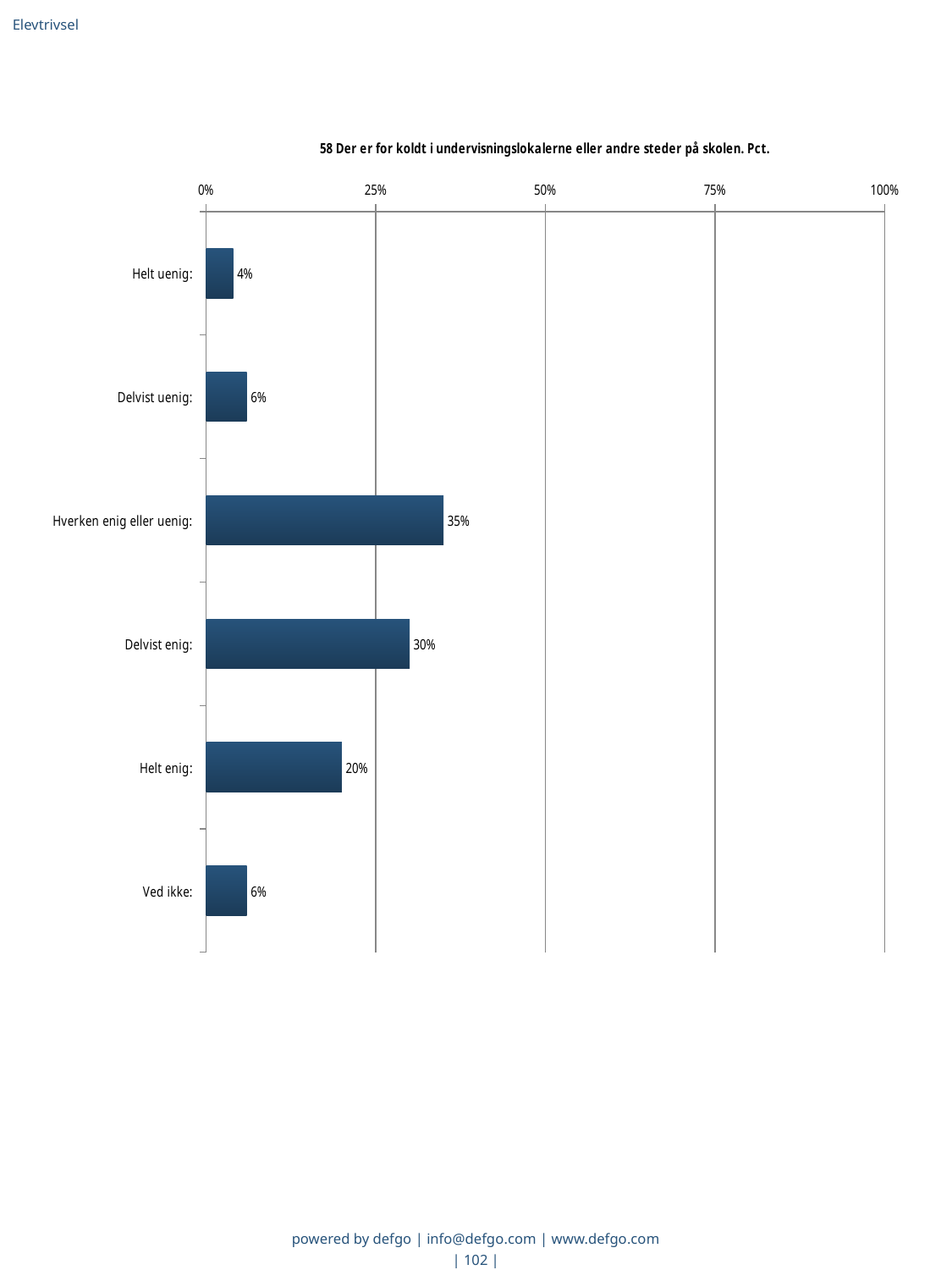
What is the value for "Hverken enig eller uenig"? 35% What is the difference between the values for "Hverken enig eller uenig" and "Delvist enig"? 5% Which category has the highest value? Hverken enig eller uenig What is the value for "Delvist enig"? 30% What is the value for "Helt enig"? 20% What is the difference between the values for "Helt enig" and "Helt uenig"? 16% How many categories are shown in the chart? 6 What kind of chart is shown on the slide? Bar chart What is the title of the chart? 58 Der er for koldt i undervisningslokalerne eller andre steder på skolen. Pct. Is the value for "Hverken enig eller uenig" greater or less than 25%? greater Which category has the lowest value? Helt uenig Which is larger, the value for "Delvist enig" or the value for "Helt enig"? Delvist enig